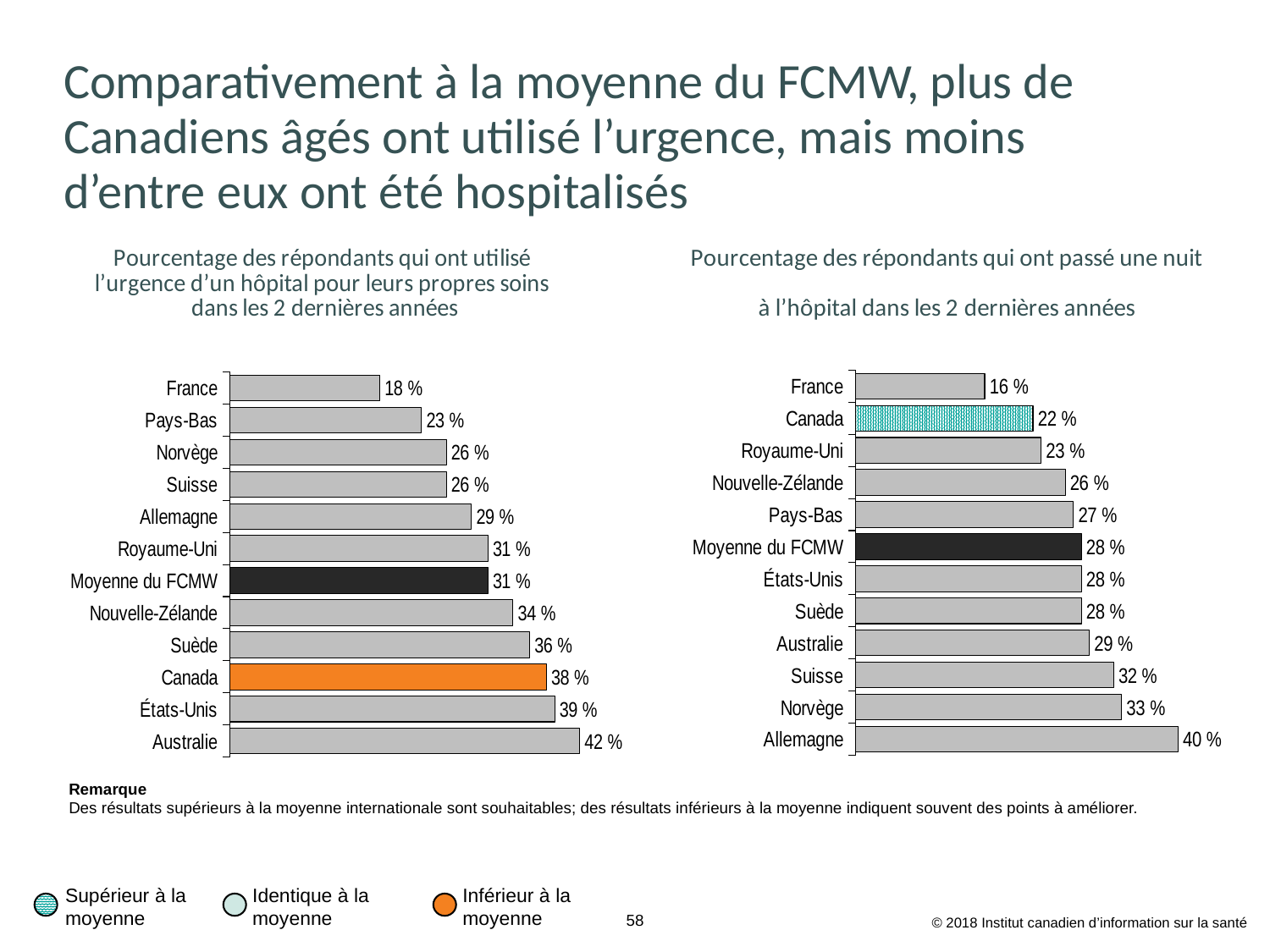
In the left chart (emergency department use), what is the difference between Canada and Moyenne du FCMW? 7 % In the left chart (emergency department use), what colour is the bar for Canada? Orange In the right chart (overnight hospital stay), what is the difference between Allemagne and France? 24 % In the right chart (overnight hospital stay), which is larger, the value for Canada or the value for Moyenne du FCMW? Moyenne du FCMW In the right chart (overnight hospital stay), what is the value for Canada? 22 % In the left chart (emergency department use), how many categories are shown? 12 In the left chart (emergency department use), which country has the highest value? Australie In the left chart (emergency department use), what is the value for Canada? 38 % In the right chart (overnight hospital stay), which country has the lowest value? France In the right chart (overnight hospital stay), which country has the highest value? Allemagne In the left chart (emergency department use), what is the value for Moyenne du FCMW? 31 % What type of chart is the right chart (overnight hospital stay)? Bar chart